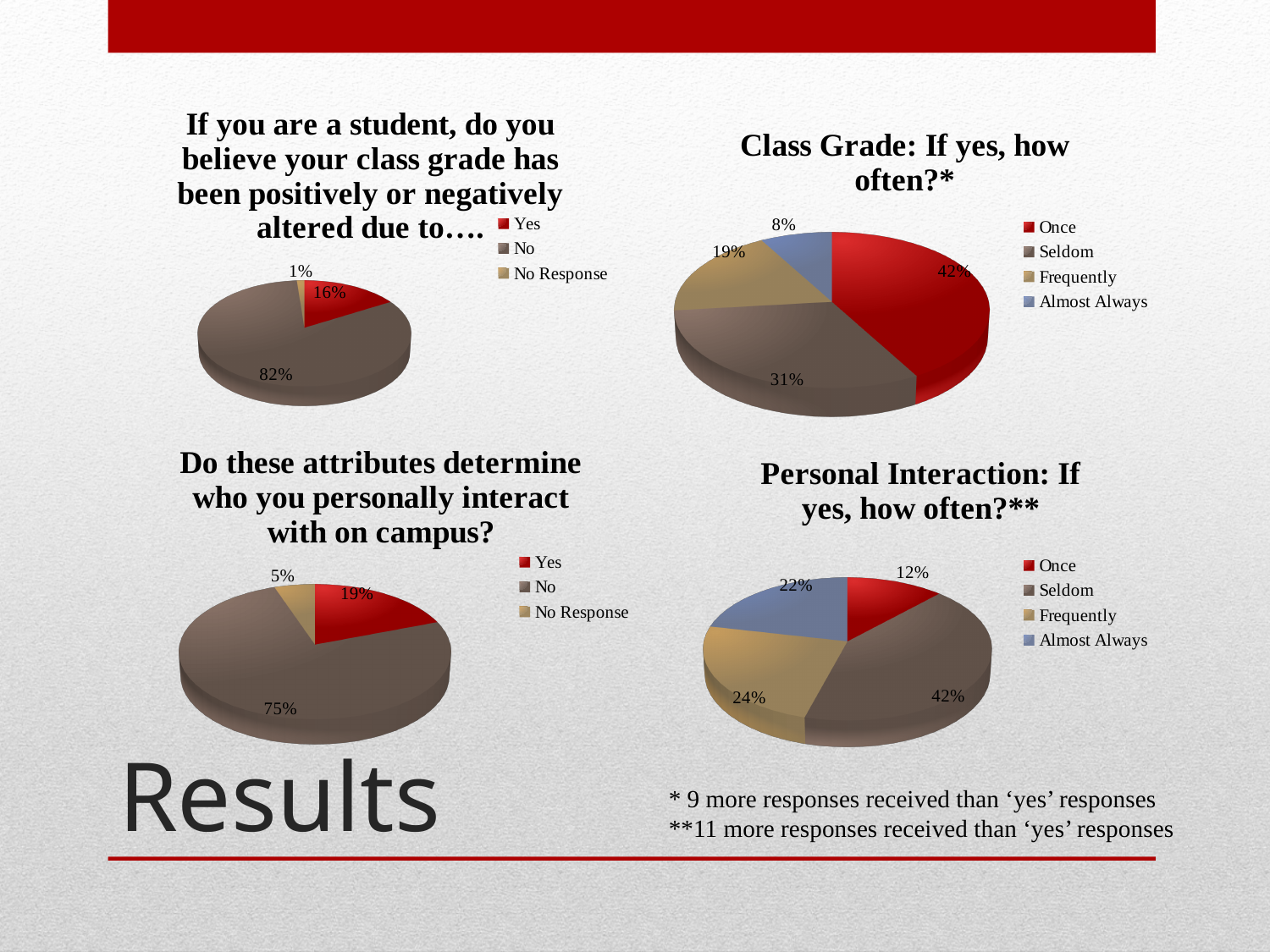
What type of chart is the 'Class Grade: If yes, how often?' chart? Pie chart In the bottom-left pie chart (personal interaction on campus), what percentage answered No Response? 5% In the 'Personal Interaction: If yes, how often?' chart, which category has the smallest share? Once In the 'Class Grade: If yes, how often?' chart, what is the share for Seldom? 31% How many categories does the legend of the 'Personal Interaction: If yes, how often?' chart list? 4 In the 'Class Grade: If yes, how often?' chart, what is the difference between the Once and Frequently shares? 23% In the 'Personal Interaction: If yes, how often?' chart, what is the share for Seldom? 42% In the 'Class Grade: If yes, how often?' chart, which category has the smallest share? Almost Always In the top-left pie chart (class grade altered), what percentage answered No? 82% In the top-left pie chart (class grade altered), what percentage answered Yes? 16% In the 'Class Grade: If yes, how often?' chart, which category has the largest share? Once In the bottom-left pie chart (personal interaction on campus), which is larger, Yes or No? No